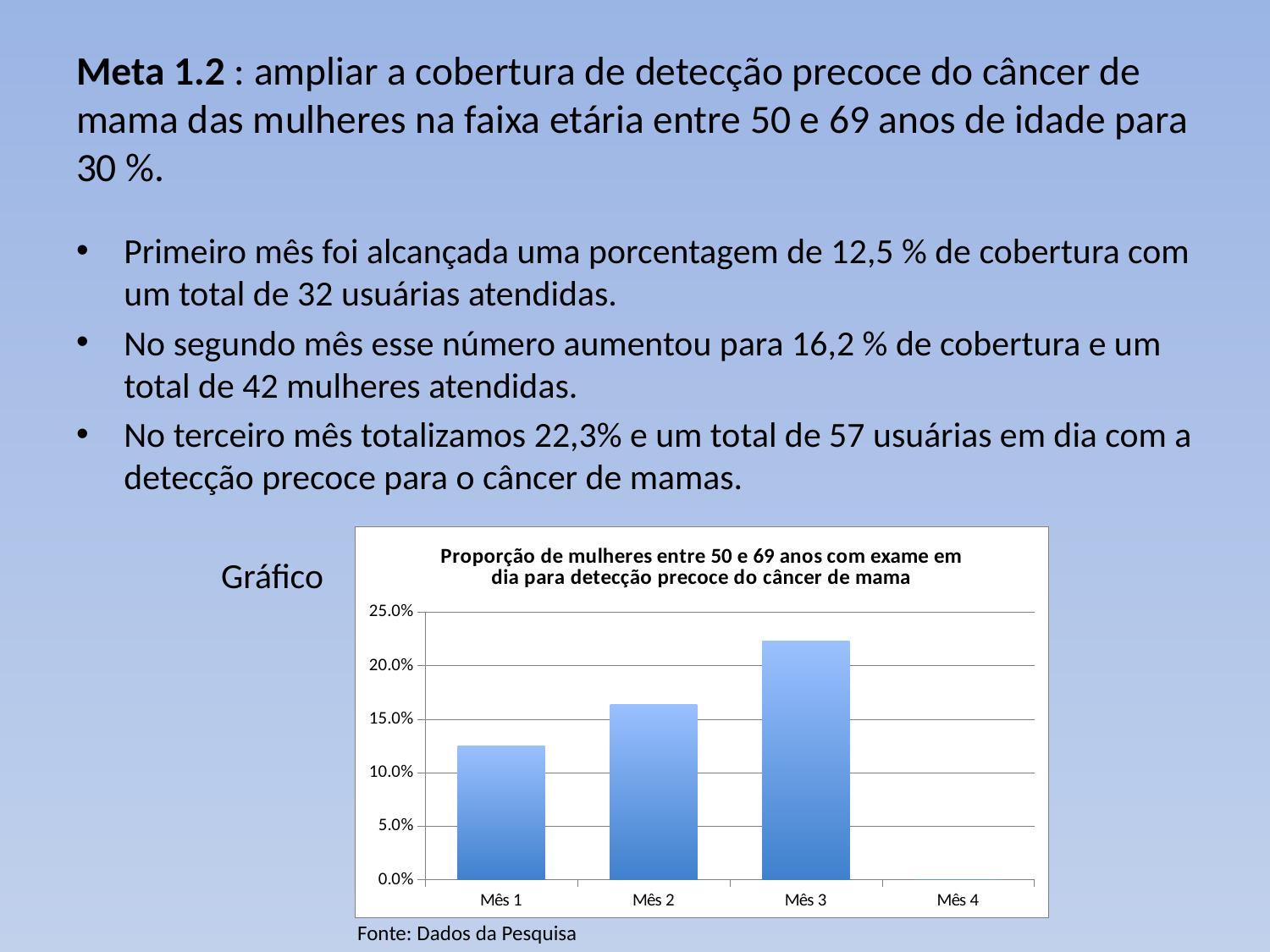
Is the value for Mês 3 greater or less than 25.0%? less Is the value for Mês 1 greater or less than 15.0%? less Is the value for Mês 1 greater or less than 10.0%? greater What kind of chart is shown on the slide? bar chart Which is larger, the value for Mês 2 or the value for Mês 3? Mês 3 Which month has the highest bar in the chart? Mês 3 What source is cited below the chart? Fonte: Dados da Pesquisa How many categories are shown on the x axis of the chart? 4 Which of the plotted months has the lowest bar in the chart? Mês 1 Do the bar values rise or fall from Mês 1 to Mês 3? rise